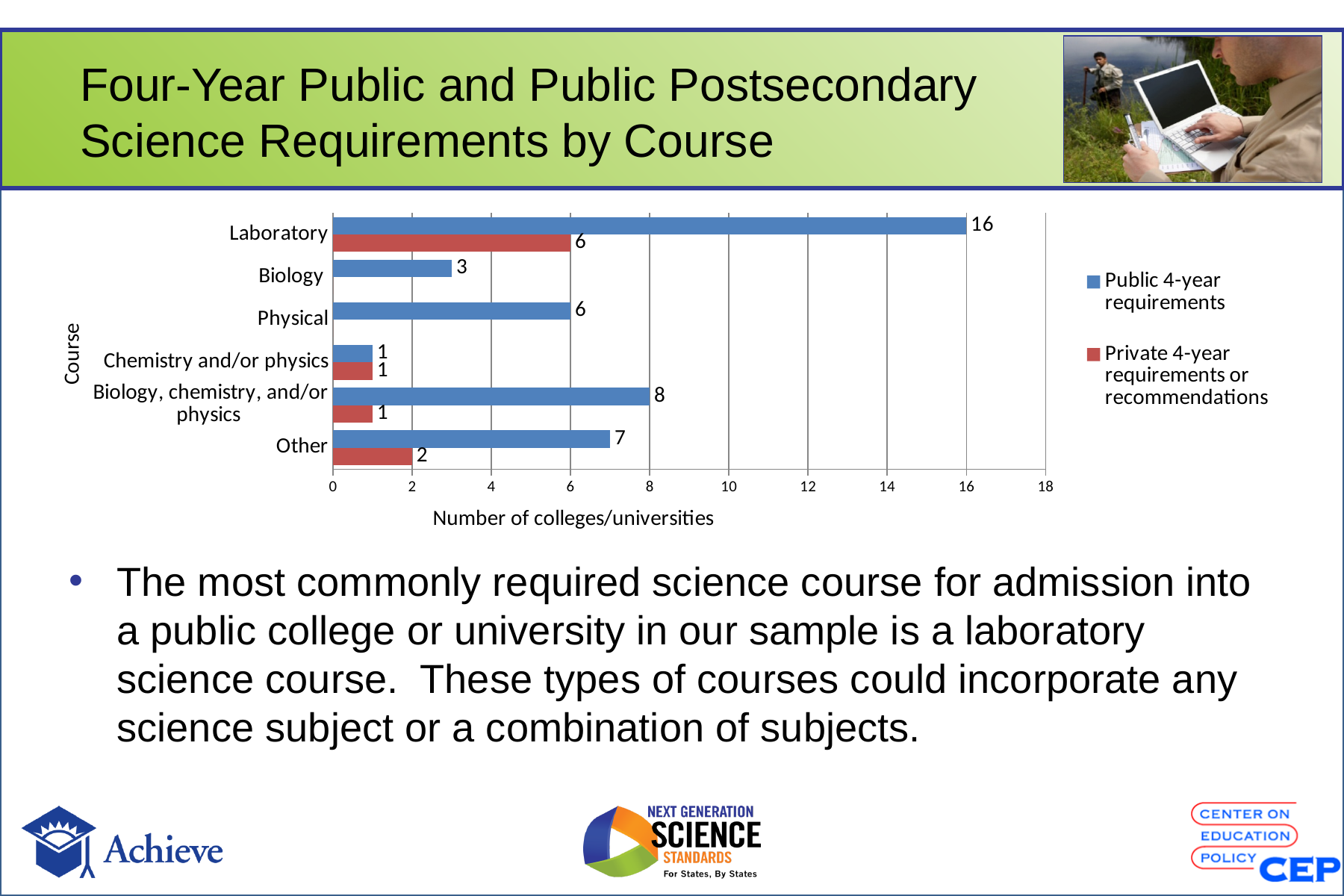
What type of chart is shown on the slide? bar chart What is the value for Laboratory in the Public 4-year requirements series? 16 What is the value for Laboratory in the Private 4-year requirements or recommendations series? 6 How many series does the legend list? 2 What is the label of the x axis? Number of colleges/universities What is the value for Other in the Private 4-year requirements or recommendations series? 2 Which course has the highest value in the Public 4-year requirements series? Laboratory What is the difference between the Public 4-year requirements values for Laboratory and Biology, chemistry, and/or physics? 8 Which is larger for Other: the Public 4-year requirements value or the Private 4-year requirements or recommendations value? Public 4-year requirements What is the value for Biology in the Public 4-year requirements series? 3 How many course categories are shown on the y axis? 6 Which course has the lowest value in the Public 4-year requirements series? Chemistry and/or physics